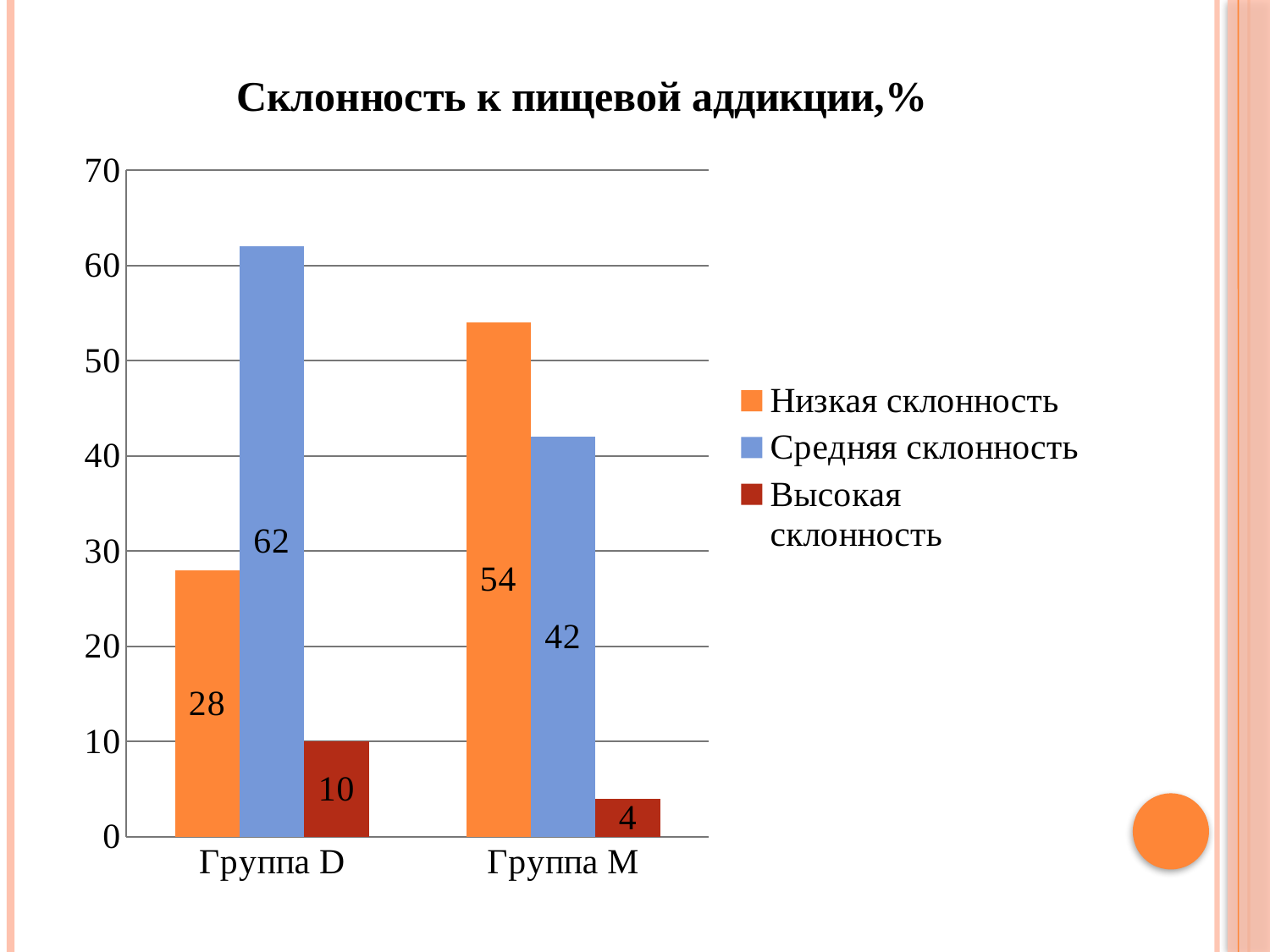
Which is larger: Высокая склонность in Группа D or Высокая склонность in Группа M? Группа D What kind of chart is shown on the slide? bar chart Which series has the lowest value in Группа M? Высокая склонность Is the value for Низкая склонность in Группа M greater or less than 50? greater Which series has the highest value in Группа D? Средняя склонность What is the value for Высокая склонность in Группа D? 10 What is the value for Средняя склонность in Группа M? 42 How many groups are shown on the x axis? 2 How many series does the legend list? 3 What is the value for Низкая склонность in Группа D? 28 What is the difference between Средняя склонность in Группа D and Средняя склонность in Группа M? 20 What is the difference between Низкая склонность in Группа M and Низкая склонность in Группа D? 26